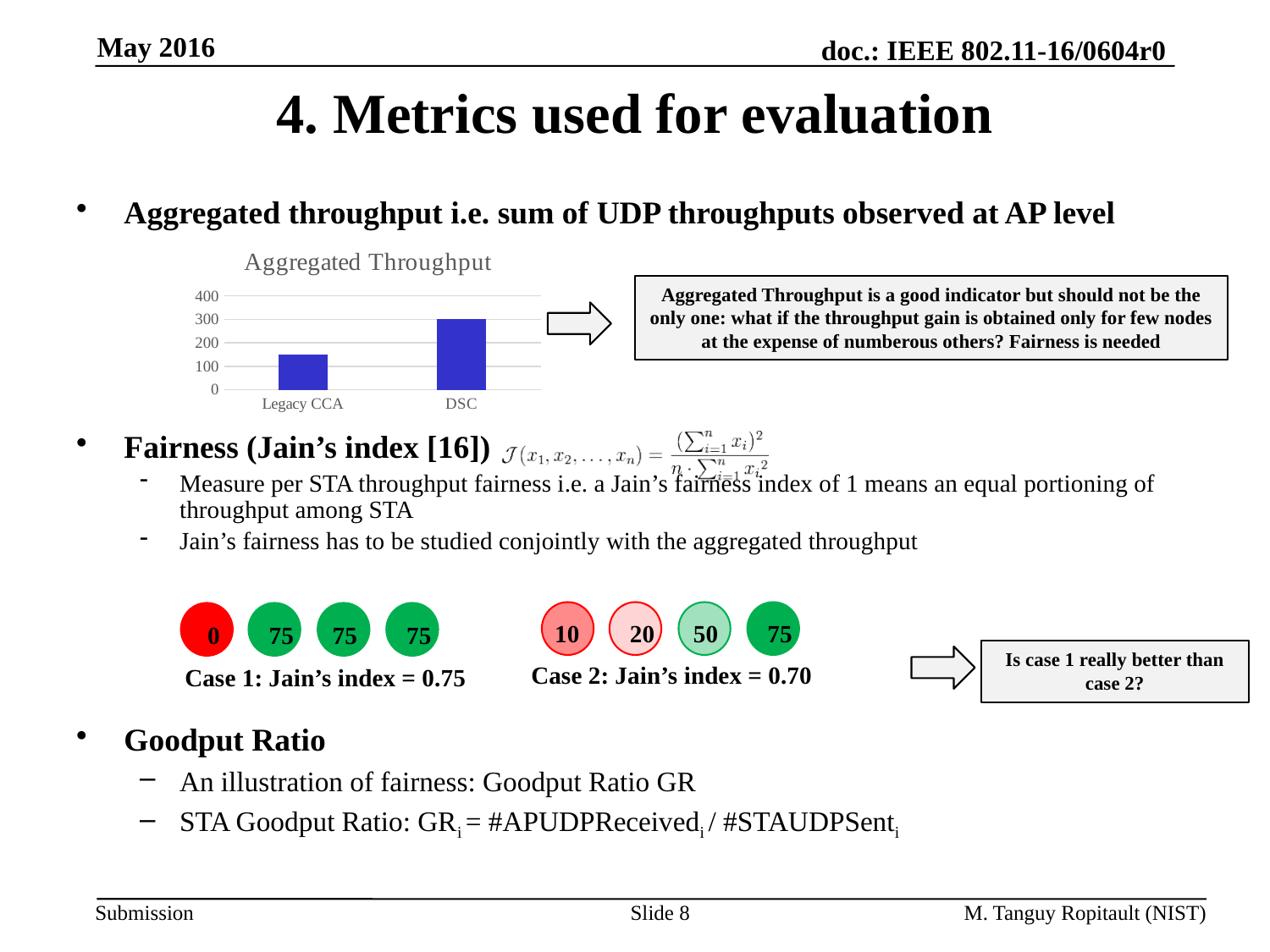
What kind of chart is the Aggregated Throughput chart? bar chart How many categories are shown on the x axis of the Aggregated Throughput chart? 2 In the Aggregated Throughput chart, which is larger: the value for Legacy CCA or the value for DSC? DSC In the Aggregated Throughput chart, is the value for DSC greater or less than 200? greater What is the title of the bar chart on the slide? Aggregated Throughput What is the highest tick value shown on the y axis of the Aggregated Throughput chart? 400 In the Aggregated Throughput chart, is the value for Legacy CCA greater or less than 100? greater In the Aggregated Throughput chart, is the value for Legacy CCA greater or less than 200? less Do the values in the Aggregated Throughput chart rise or fall from Legacy CCA to DSC? rise Which category has the highest value in the Aggregated Throughput chart? DSC Which category has the lowest value in the Aggregated Throughput chart? Legacy CCA